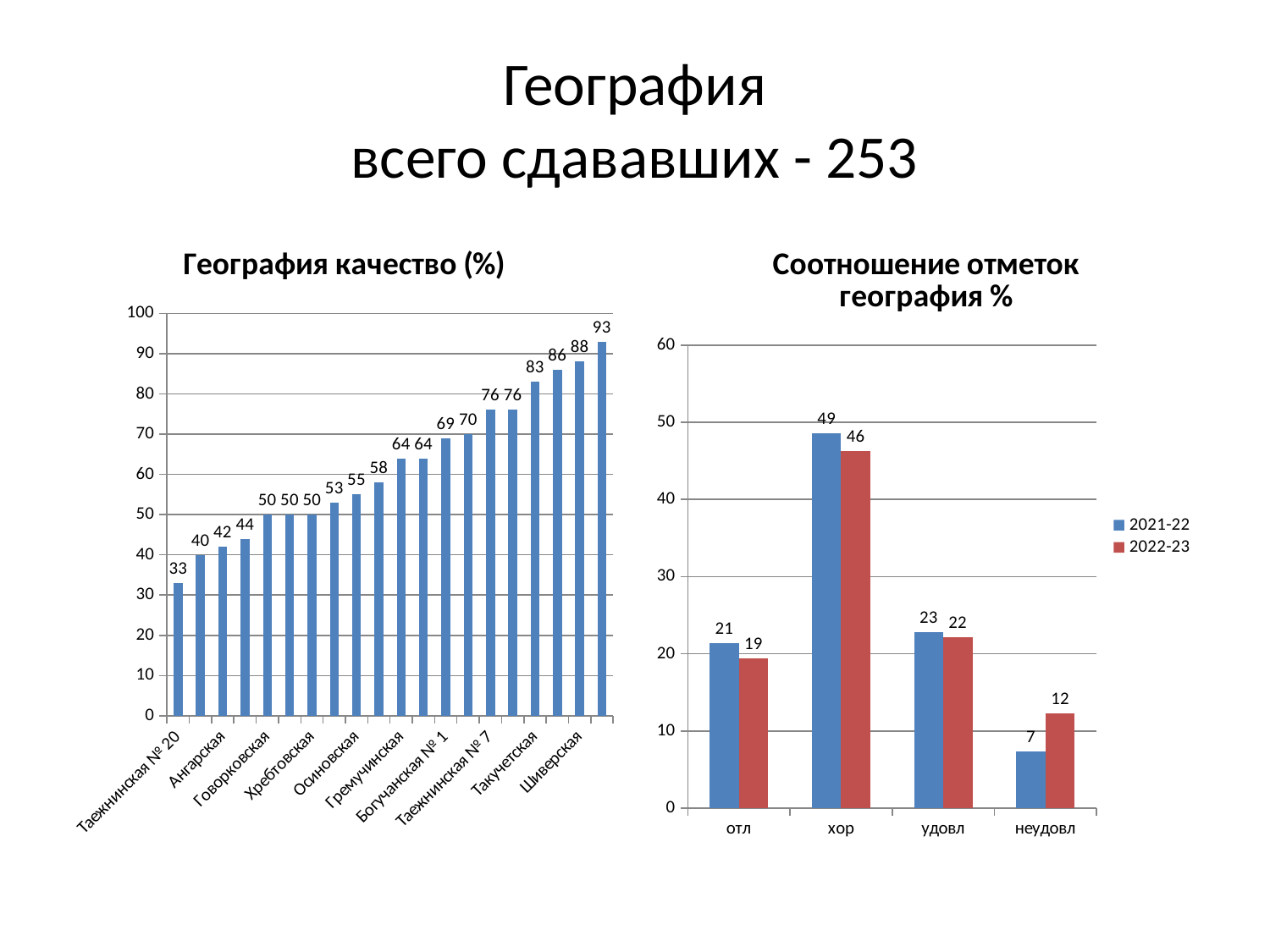
In the chart 'География качество (%)', do the values rise or fall from left to right along the x axis? rise In the chart 'Соотношение отметок география %', which category has the lowest value for 2021-22? неудовл In the chart 'Соотношение отметок география %', what is the value for неудовл in 2022-23? 12 In the chart 'География качество (%)', what is the lowest value shown? 33 In the chart 'Соотношение отметок география %', which category has the highest value for 2022-23? хор In the chart 'Соотношение отметок география %', which year has the larger value for неудовл, 2021-22 or 2022-23? 2022-23 In the chart 'Соотношение отметок география %', what is the difference between the 2021-22 and 2022-23 values for отл? 2 In the chart 'Соотношение отметок география %', what is the value for хор in 2021-22? 49 In the chart 'География качество (%)', what is the highest value shown? 93 How many categories are shown on the x axis of the chart 'Соотношение отметок география %'? 4 What kind of chart is 'География качество (%)'? bar chart How many series does the legend of the chart 'Соотношение отметок география %' list? 2